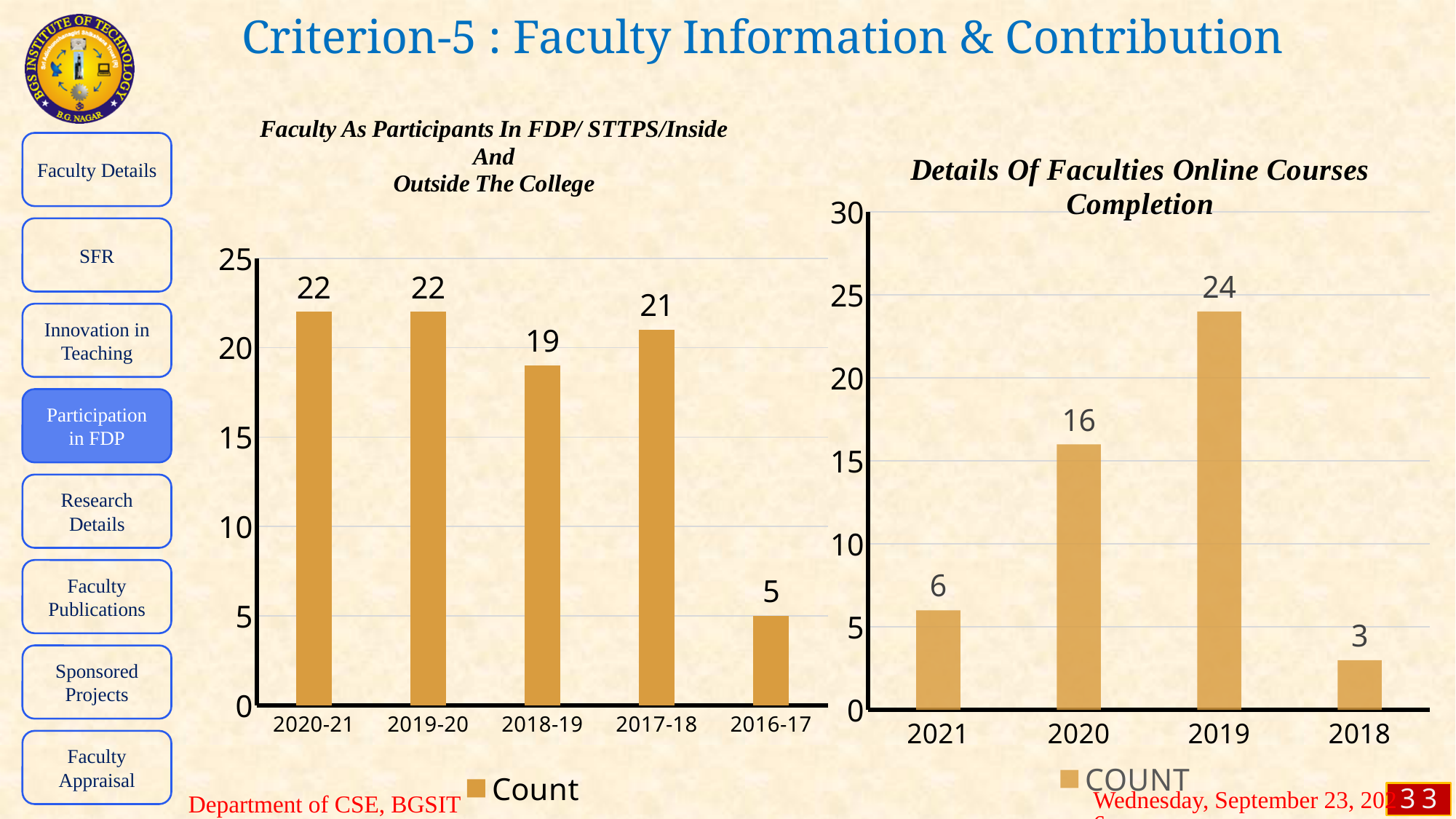
In the 'Details Of Faculties Online Courses Completion' chart, what is the difference between the counts for 2019 and 2021? 18 In the 'Faculty As Participants In FDP/ STTPS/Inside And Outside The College' chart, which is larger, the count for 2018-19 or 2017-18? 2017-18 In the 'Faculty As Participants In FDP/ STTPS/Inside And Outside The College' chart, what is the count for 2018-19? 19 How many series does the legend of the 'Faculty As Participants In FDP/ STTPS/Inside And Outside The College' chart list? 1 In the 'Details Of Faculties Online Courses Completion' chart, is the value for 2021 greater or less than 10? less In the 'Faculty As Participants In FDP/ STTPS/Inside And Outside The College' chart, how many year categories are shown? 5 What kind of chart is the 'Details Of Faculties Online Courses Completion' chart? Bar chart In the 'Faculty As Participants In FDP/ STTPS/Inside And Outside The College' chart, what is the difference between the counts for 2017-18 and 2016-17? 16 In the 'Details Of Faculties Online Courses Completion' chart, which year has the lowest count? 2018 In the 'Faculty As Participants In FDP/ STTPS/Inside And Outside The College' chart, which year has the lowest count? 2016-17 In the 'Details Of Faculties Online Courses Completion' chart, what is the count for 2020? 16 In the 'Details Of Faculties Online Courses Completion' chart, which year has the highest count? 2019